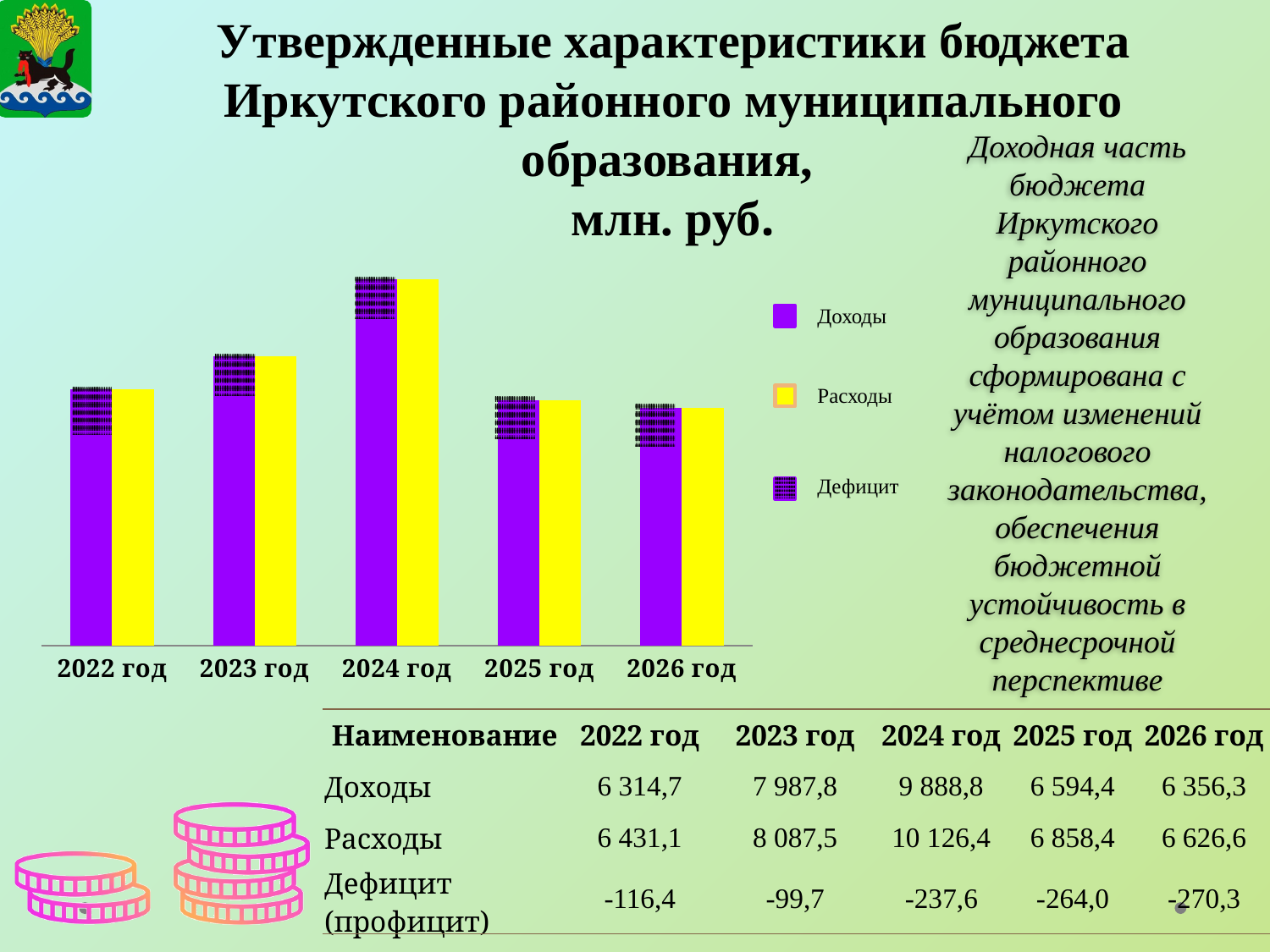
How do Доходы change from 2022 год to 2024 год? they rise Which colour represents Доходы in the chart legend? purple What is the value of Дефицит (профицит) for 2026 год? -270,3 What type of chart is shown on the slide? bar chart In which year are Доходы the lowest? 2022 год Which is larger in 2023 год: Доходы or Расходы? Расходы How many series does the chart legend list? 3 What is the value of Доходы for 2024 год? 9 888,8 What is the difference between Расходы and Доходы in 2024 год? 237,6 How many years (categories) are shown on the x axis of the chart? 5 What is the value of Расходы for 2025 год? 6 858,4 In which year are Расходы the highest? 2024 год